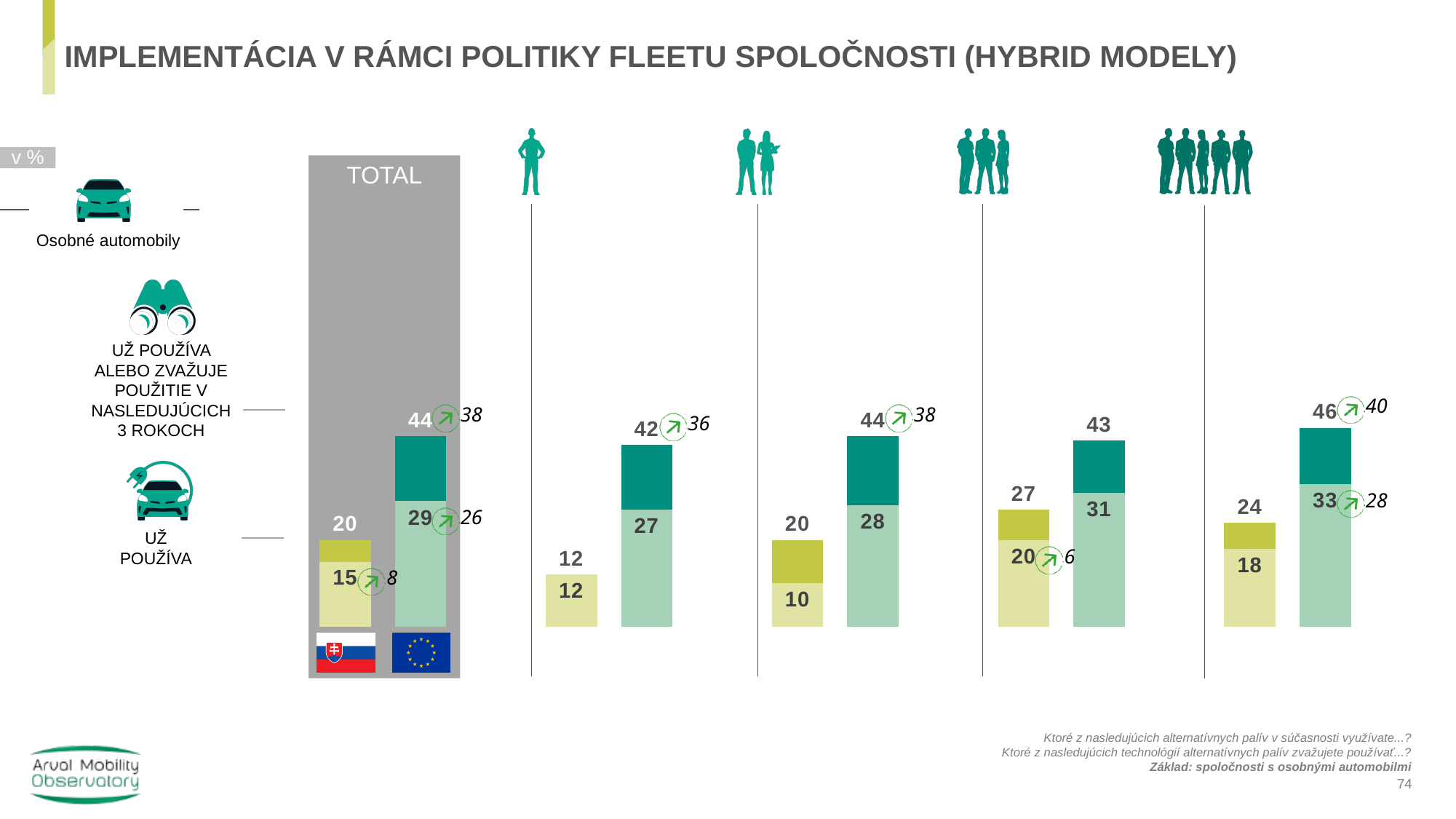
Across all groups, which Slovak bar has the lowest top value? The first group right of TOTAL (12) In the TOTAL column, what is the difference between the EU top value (44) and the Slovak top value (20)? 24 In the rightmost group (largest company icon), what is the top value for the EU bar? 46 In the TOTAL column, what is the 'Už používa' value for the EU bar? 29 In the TOTAL column, what is the value for Slovakia for 'Už používa alebo zvažuje použitie v nasledujúcich 3 rokoch' (the top label on the Slovak bar)? 20 What type of chart is shown on the slide? Bar chart In the second group right of TOTAL, which bar has the larger top value, Slovakia or EU? EU In the TOTAL column, what is the top value shown for the EU bar? 44 In the rightmost group (largest company icon), what is the 'Už používa' value for the Slovak bar? 18 In the TOTAL column, what is the 'Už používa' value for the Slovak bar? 15 Across all groups, which EU bar has the highest top value? The rightmost group (46) What unit are the values on the chart expressed in, according to the label at the top left? %